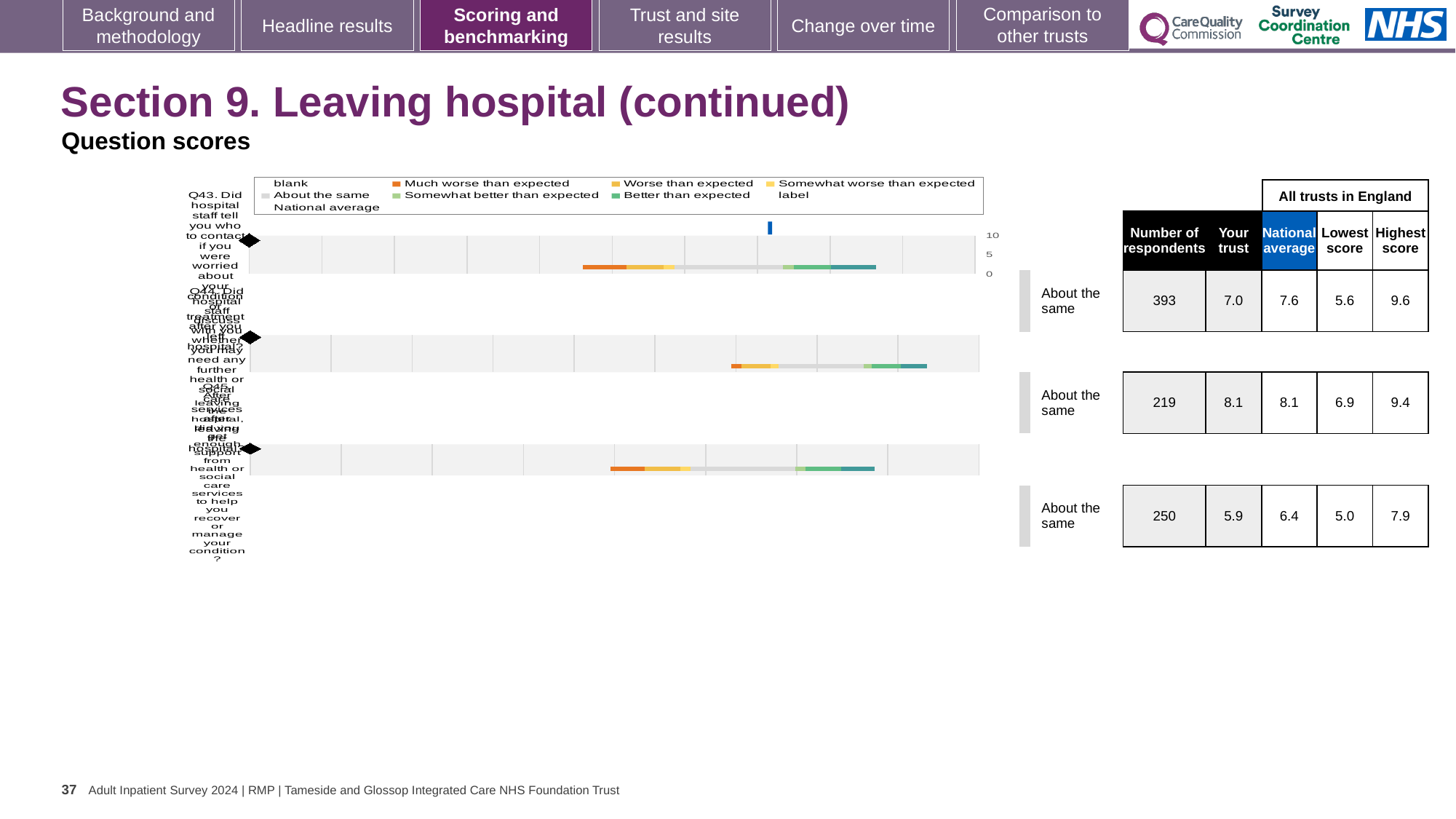
For the top chart (Q43), what is the difference between the national average and the 'Your trust' score? 0.6 How many question score charts are shown on the slide? 3 For the top chart (Q43), what is the national average score? 7.6 For the top chart (Q43), how many respondents are listed? 393 Which of the three charts has the highest 'Your trust' score? The middle chart (Q44) For the bottom chart (Q45), which is larger: the 'Your trust' score or the national average? National average What kind of chart is used for the three question score charts on the slide? bar chart For the bottom chart (Q45), what is the national average score? 6.4 For the middle chart (Q44), what is the 'Your trust' score? 8.1 What benchmark category label is shown next to each of the three charts? About the same For the bottom chart (Q45), what is the lowest score among all trusts in England? 5.0 For the top chart (Q43), what is the 'Your trust' score shown in the table? 7.0